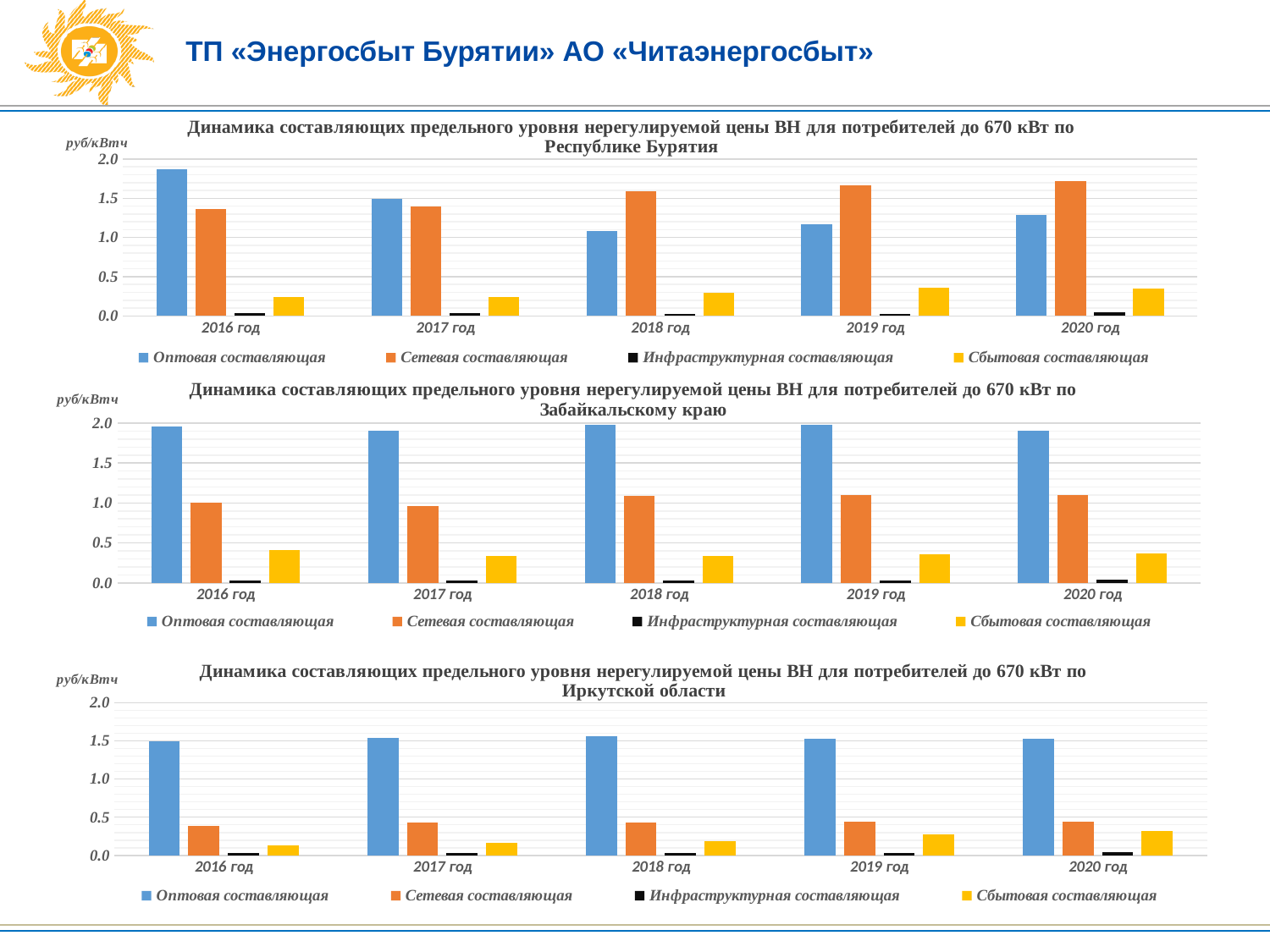
In the top chart (Республика Бурятия), is the value of Оптовая составляющая for 2016 год greater or less than 1.5? greater In the top chart (Республика Бурятия), which is larger for 2020 год: Оптовая составляющая or Сетевая составляющая? Сетевая составляющая What kind of chart is the chart titled «Динамика ... по Республике Бурятия» (the top chart)? bar chart In the top chart (Республика Бурятия), how many series does the legend list? 4 In the middle chart (Забайкальский край), is the value of Оптовая составляющая for 2016 год greater or less than 1.5? greater In the top chart (Республика Бурятия), is the value of Сетевая составляющая for 2020 год greater or less than 1.5? greater In the top chart (Республика Бурятия), which is larger for 2016 год: Оптовая составляющая or Сетевая составляющая? Оптовая составляющая In the top chart (Республика Бурятия), how many years are shown on the x axis? 5 In the top chart (Республика Бурятия), does Сетевая составляющая rise or fall from 2016 год to 2020 год? rise In the bottom chart (Иркутская область), in which year is Сбытовая составляющая lowest? 2016 год In the top chart (Республика Бурятия), in which year is Оптовая составляющая highest? 2016 год